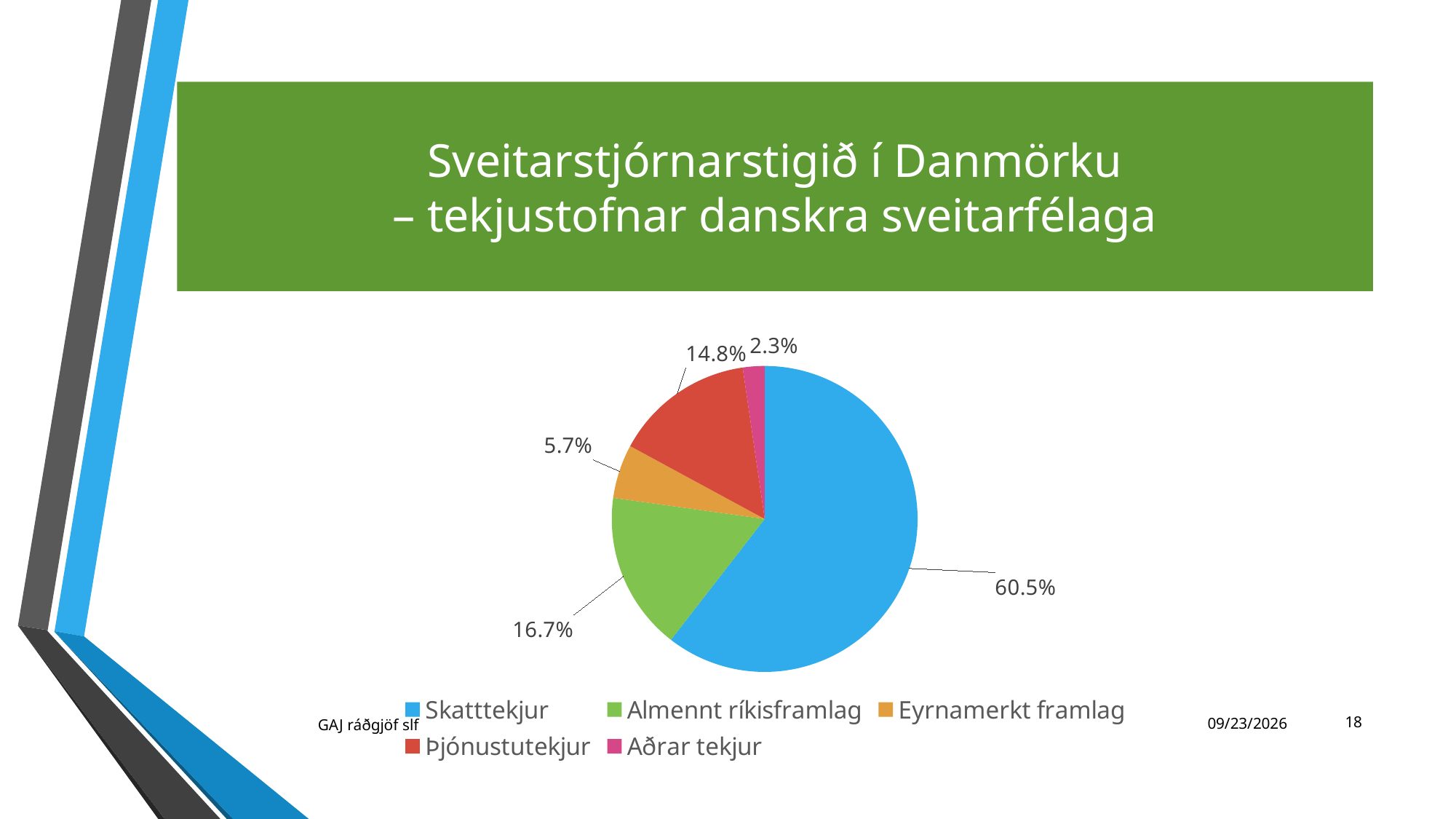
Which category has the largest slice of the pie? Skatttekjur What share of the pie does Þjónustutekjur represent? 14.8% What share of the pie does Skatttekjur represent? 60.5% What share of the pie does Almennt ríkisframlag represent? 16.7% What kind of chart is shown on the slide? Pie chart Which is larger, Þjónustutekjur or Eyrnamerkt framlag? Þjónustutekjur What is the difference in percentage points between Skatttekjur and Almennt ríkisframlag? 43.8 Which category has the smallest slice of the pie? Aðrar tekjur What share of the pie does Eyrnamerkt framlag represent? 5.7% What colour is the Skatttekjur slice? Blue How many categories does the pie chart show? 5 What share of the pie does Aðrar tekjur represent? 2.3%